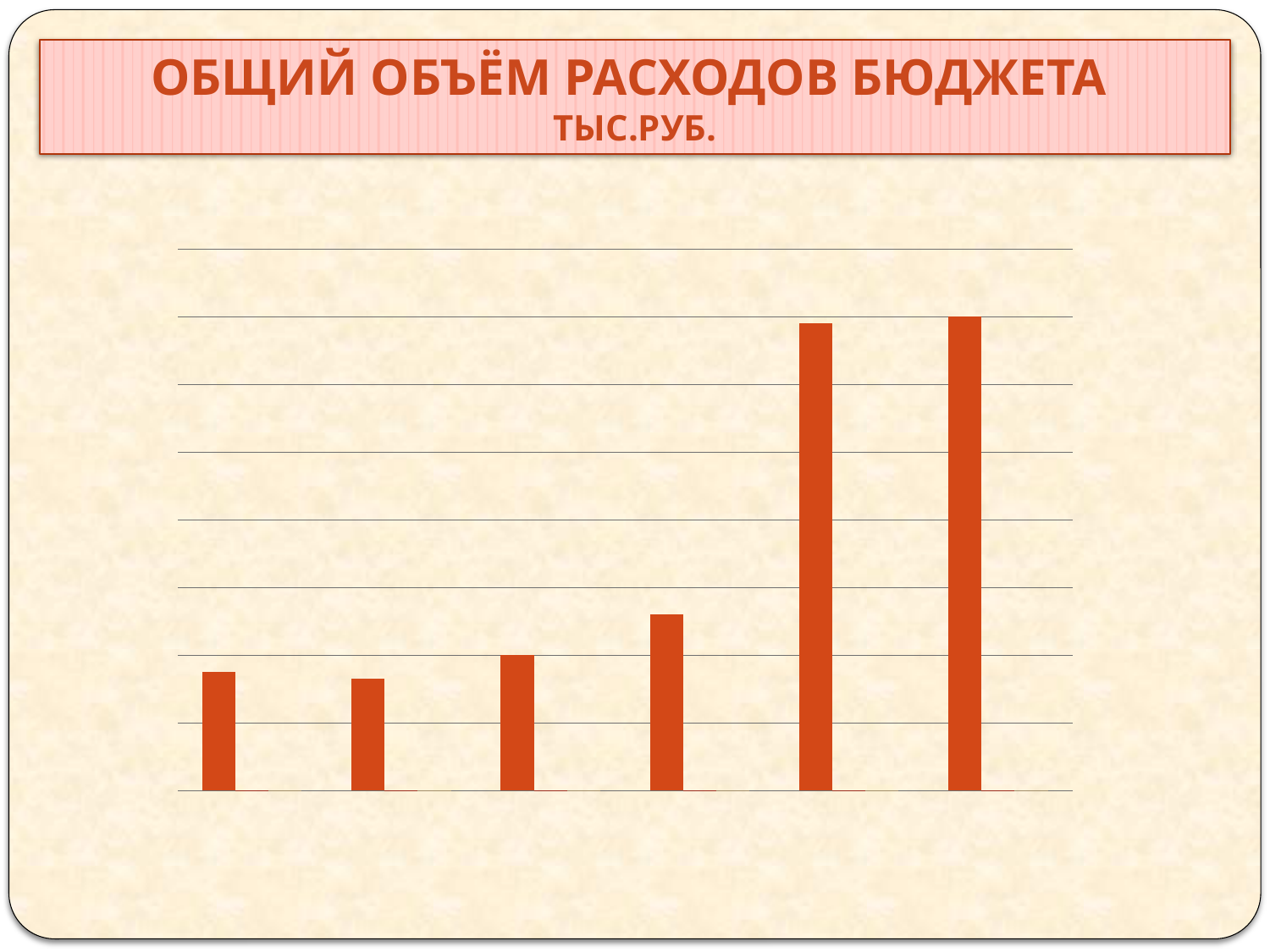
Do the bars overall rise or fall from left to right across the chart? rise Which is larger, the sixth bar from the left or the fourth bar from the left? the sixth bar Which is larger, the fourth bar from the left or the first bar from the left? the fourth bar What kind of chart is shown on the slide? bar chart What is the title of the chart on the slide? ОБЩИЙ ОБЪЁМ РАСХОДОВ БЮДЖЕТА ТЫС.РУБ. How many bars does the chart contain? 6 In what units are the values of the chart expressed, according to the title? тыс.руб. Which is larger, the fifth bar from the left or the third bar from the left? the fifth bar